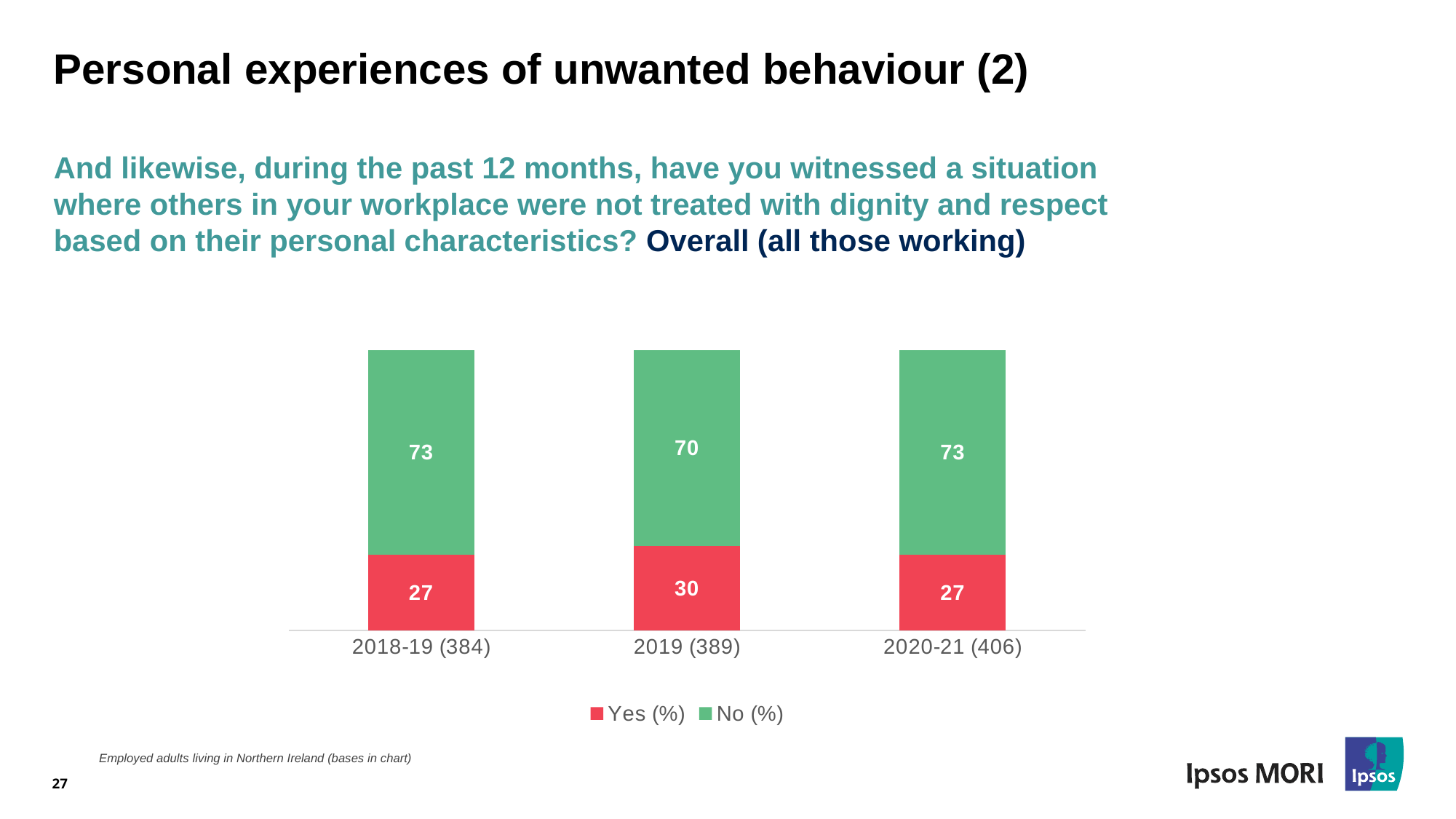
What is the Yes (%) value for 2019 (389)? 30 How many categories are shown on the x axis? 3 What is the Yes (%) value for 2020-21 (406)? 27 Which category has the lowest No (%) value? 2019 (389) What kind of chart is shown on the slide? Stacked bar chart What is the difference between the No (%) and Yes (%) values for 2019 (389)? 40 What is the No (%) value for 2018-19 (384)? 73 What is the total of the stacked bar for 2018-19 (384)? 100 Which category has the highest Yes (%) value? 2019 (389) What is the No (%) value for 2019 (389)? 70 Is the Yes (%) value larger for 2019 (389) or for 2020-21 (406)? 2019 (389) How many series does the legend list? 2